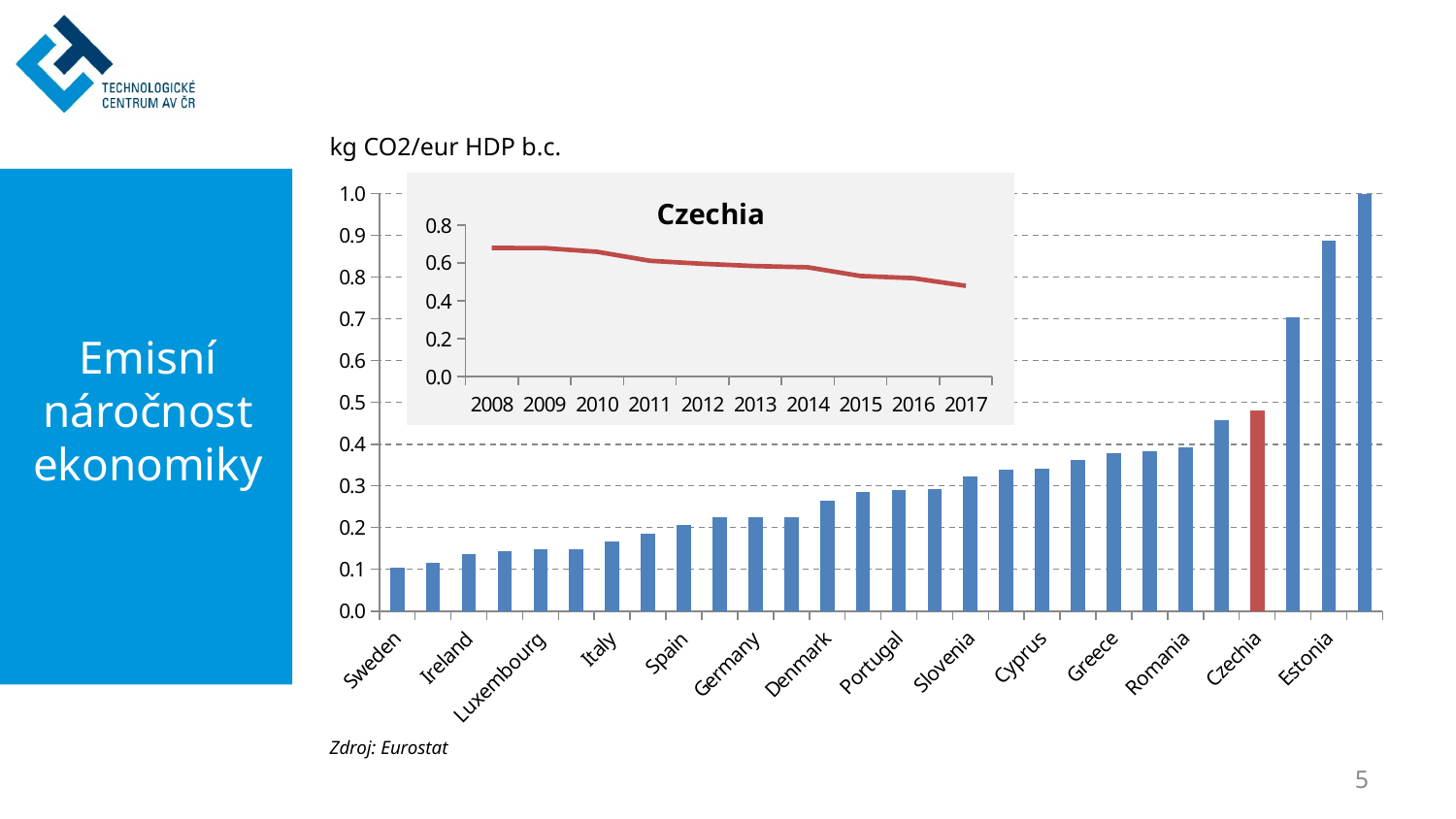
In the main bar chart, is the value for Cyprus greater or less than 0.3? greater In the main bar chart, is the value for Czechia greater or less than 0.4? greater In the main bar chart, is the value for Estonia greater or less than 0.8? greater In the main bar chart, do the values rise or fall from left to right? rise What kind of chart is the main chart on the slide? bar chart In the main bar chart, which labelled country has the lowest value? Sweden What kind of chart is the inset chart titled Czechia? line chart In the main bar chart, what colour is the bar for Czechia? red In the main bar chart, which has the larger value, Czechia or Germany? Czechia In the inset Czechia line chart, does the value rise or fall from 2008 to 2017? fall